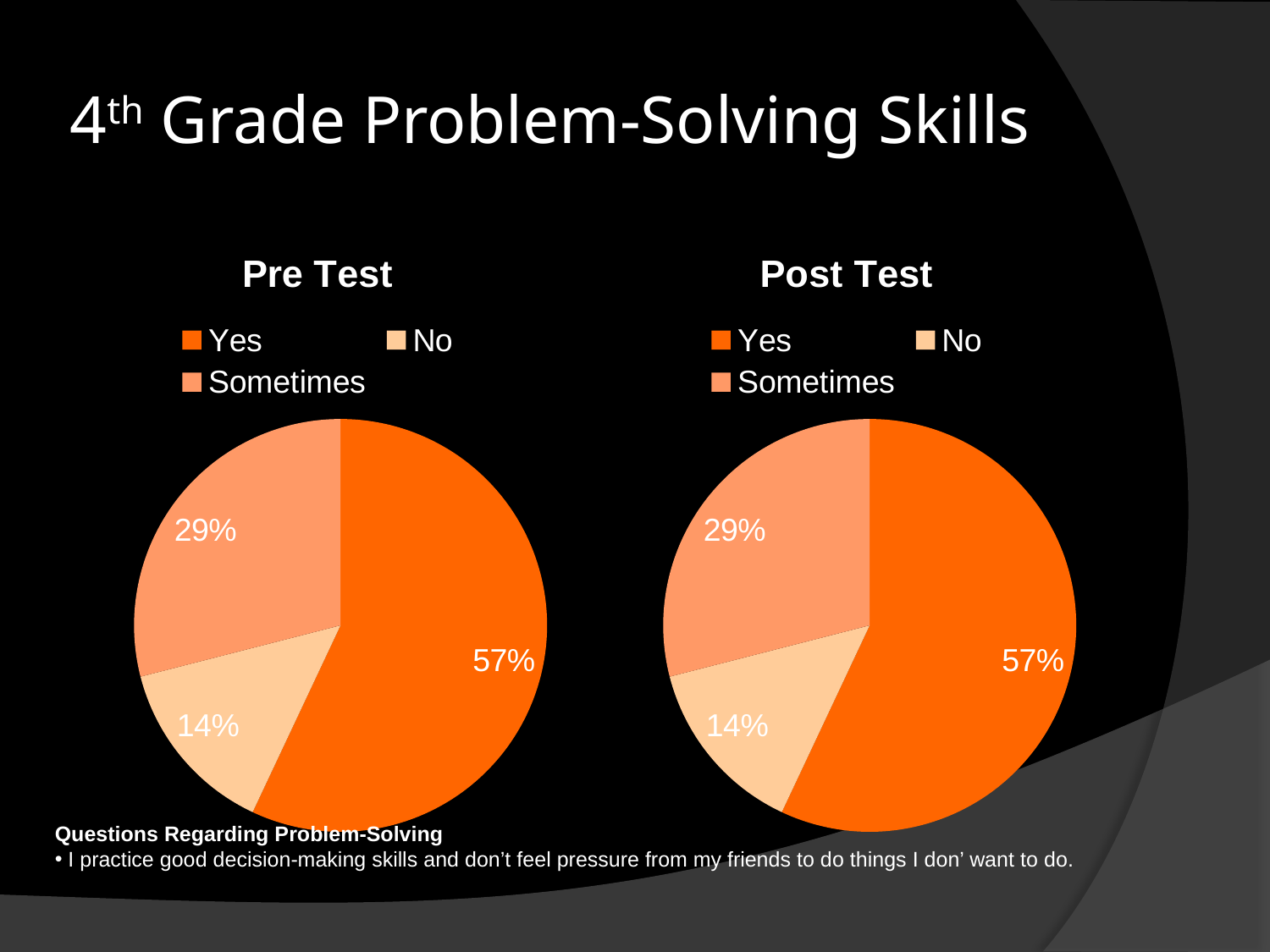
In the Post Test chart, which is larger, the "Sometimes" share or the "No" share? Sometimes What kind of chart is the Post Test chart? Pie chart In the Pre Test chart, what percentage of responses were "Yes"? 57% In the Pre Test chart, what percentage of responses were "Sometimes"? 29% What is the title of the chart on the left side of the slide? Pre Test In the Pre Test chart, what is the difference between the "Yes" and "Sometimes" shares? 28% In the Post Test chart, which category has the largest share? Yes In the Post Test chart, what percentage of responses were "No"? 14% Did the "Yes" share change between the Pre Test chart and the Post Test chart? No, it is 57% in both How many slices does the Pre Test chart have? 3 In the Pre Test chart, which category has the smallest share? No How many entries does the legend of the Post Test chart list? 3